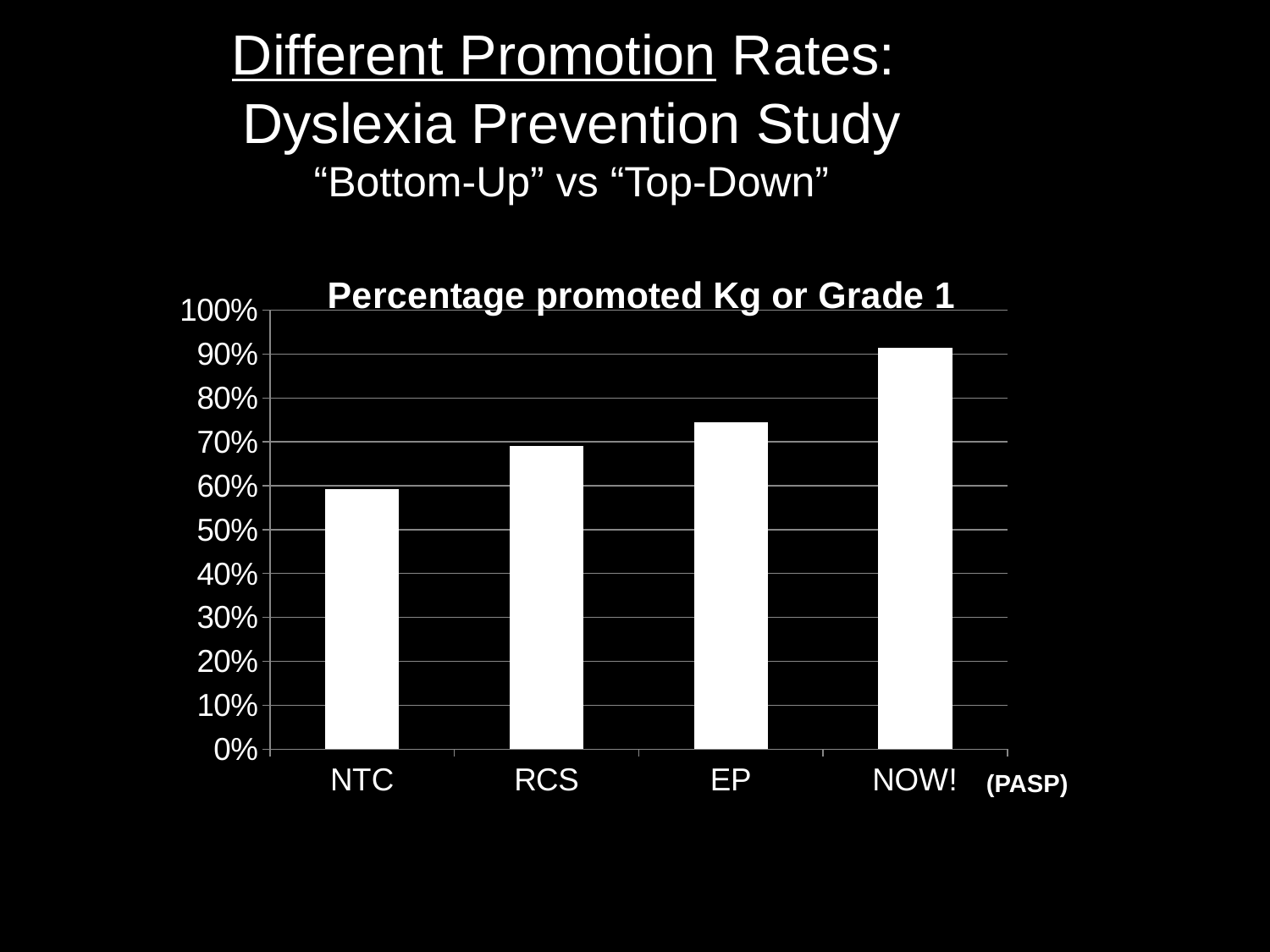
What is the title of the chart? Percentage promoted Kg or Grade 1 Is the value for NOW! greater or less than 80%? greater Is the value for RCS greater or less than 60%? greater Which has a lower percentage promoted, NTC or EP? NTC How many categories are shown on the x axis of the chart? 4 Is the value for NTC greater or less than 50%? greater Do the values rise or fall from NTC to NOW! along the x axis? rise Which category has the highest percentage promoted? NOW! Which has a higher percentage promoted, RCS or NOW!? NOW! Which category has the lowest percentage promoted? NTC What kind of chart is shown on the slide? bar chart